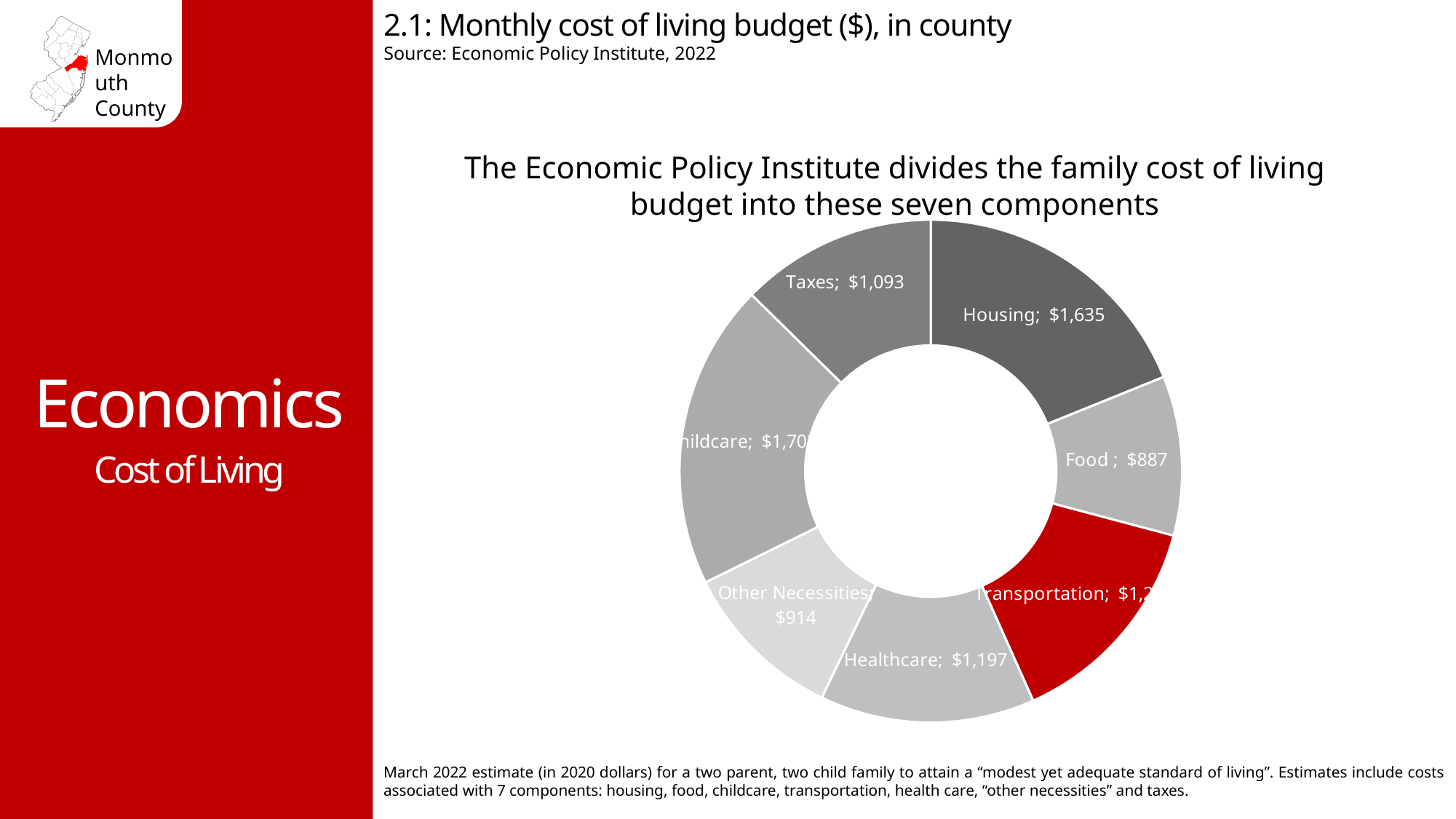
What is the difference between the Healthcare and Taxes monthly costs? $104 Which component has the lowest monthly cost in the chart? Food What is the monthly cost for Food in the chart? $887 What is the monthly cost for Taxes in the chart? $1,093 What kind of chart is shown on the slide? Doughnut (pie) chart What is the monthly cost for Housing in the chart? $1,635 What is the monthly cost for Healthcare in the chart? $1,197 Which is larger, the monthly cost for Housing or for Taxes? Housing What is the monthly cost for Other Necessities in the chart? $914 What is the difference between the Housing and Food monthly costs? $748 How many components are shown in the chart? 7 Which component's slice is coloured red in the chart? Transportation